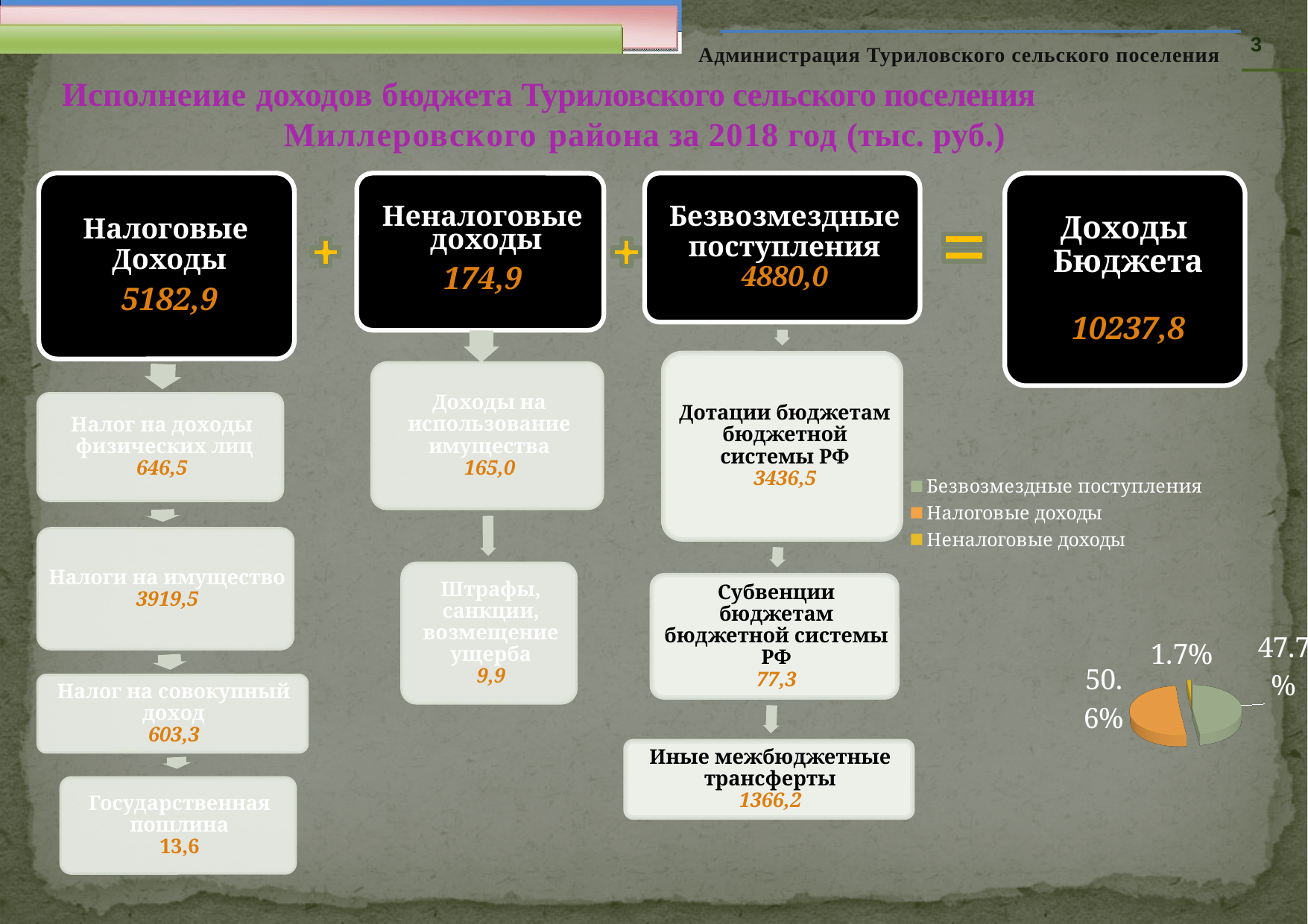
How many entries does the legend of the pie chart list? 3 In the pie chart, what is the difference in percentage points between the share of Налоговые доходы and the share of Безвозмездные поступления? 2.9 What kind of chart is shown in the bottom right of the slide? pie chart In the pie chart, what colour represents Безвозмездные поступления? green In the pie chart, which is larger: the share of Налоговые доходы or the share of Безвозмездные поступления? Налоговые доходы In the pie chart, what share is shown for Безвозмездные поступления? 47.7% In the pie chart, what colour represents Налоговые доходы? orange In the pie chart, what share is shown for Налоговые доходы? 50.6% In the pie chart, what share is shown for Неналоговые доходы? 1.7% How many slices does the pie chart have? 3 Which category has the smallest slice in the pie chart? Неналоговые доходы Which category has the largest slice in the pie chart? Налоговые доходы